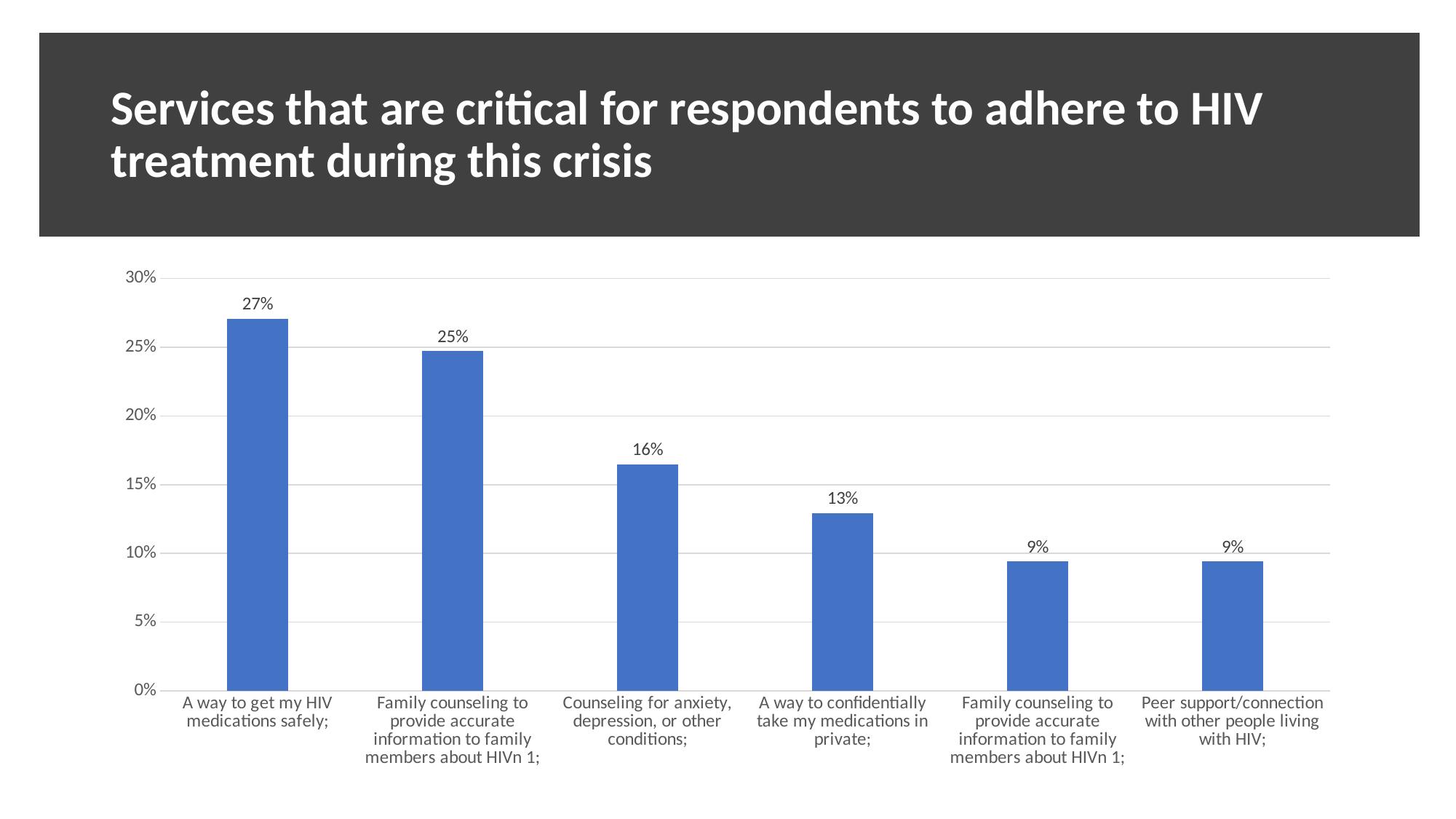
What is the value for "Counseling for anxiety, depression, or other conditions"? 16% What type of chart is shown on the slide? bar chart Which is larger: the value for "A way to confidentially take my medications in private" or the value for "Peer support/connection with other people living with HIV"? A way to confidentially take my medications in private What is the value for "A way to confidentially take my medications in private"? 13% What is the difference between the value for "A way to get my HIV medications safely" and the value for "Counseling for anxiety, depression, or other conditions"? 11% What is the lowest value shown in the chart? 9% Which category has the highest value? A way to get my HIV medications safely What is the title of the slide? Services that are critical for respondents to adhere to HIV treatment during this crisis How many bars are shown in the chart? 6 What is the value of the second bar from the left? 25% What is the value for "Peer support/connection with other people living with HIV"? 9% What is the value for "A way to get my HIV medications safely"? 27%